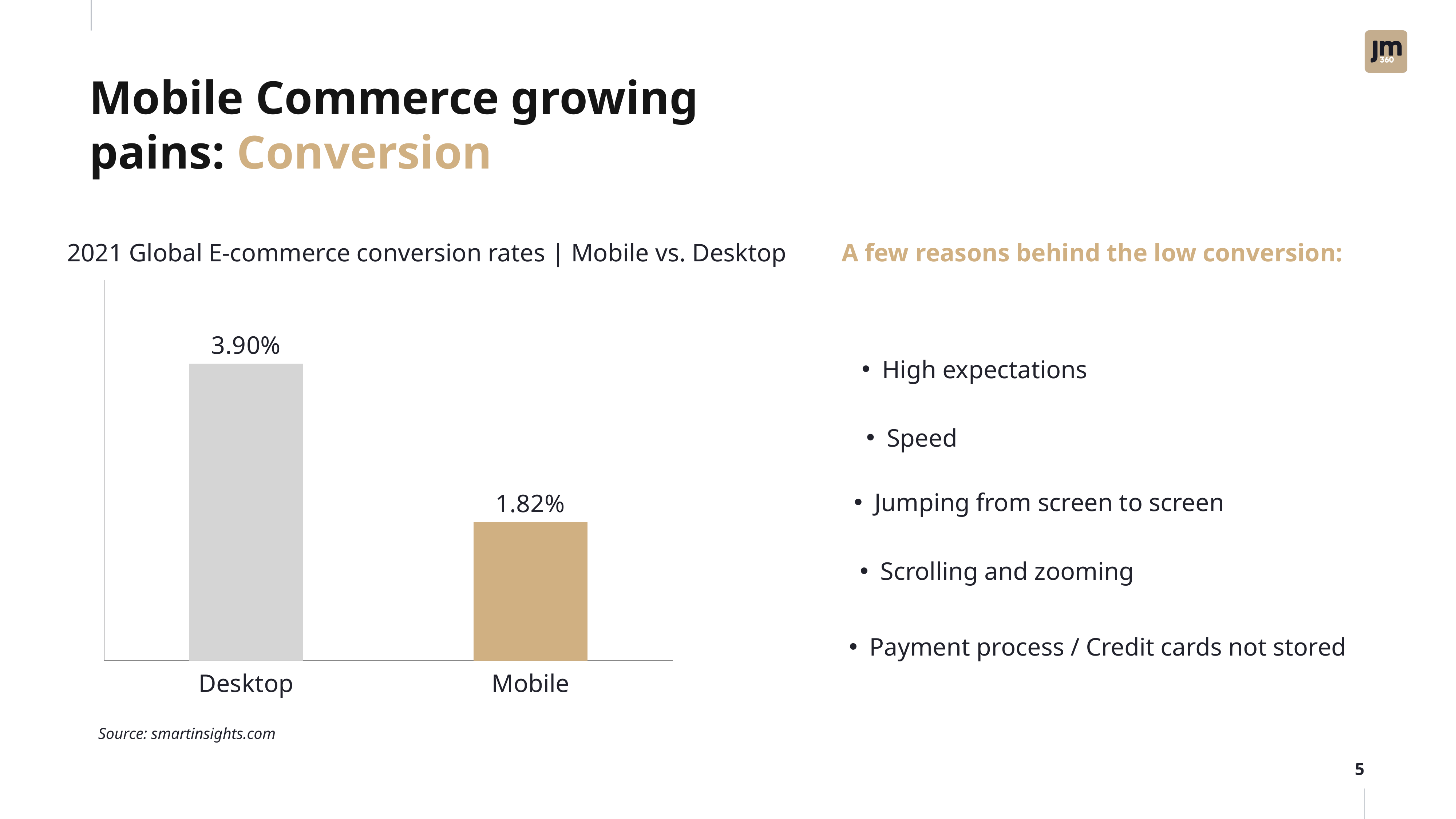
What is the conversion rate for Desktop? 3.90% Which category has the highest conversion rate? Desktop What kind of chart is shown on the slide? Bar chart Which has a higher conversion rate, Mobile or Desktop? Desktop What is the difference between the Desktop and Mobile conversion rates? 2.08% Which category has the lowest conversion rate? Mobile What is the conversion rate for Mobile? 1.82% How many categories are shown in the chart? 2 What is the title of the chart? 2021 Global E-commerce conversion rates | Mobile vs. Desktop What colour is the Mobile bar? Tan/gold